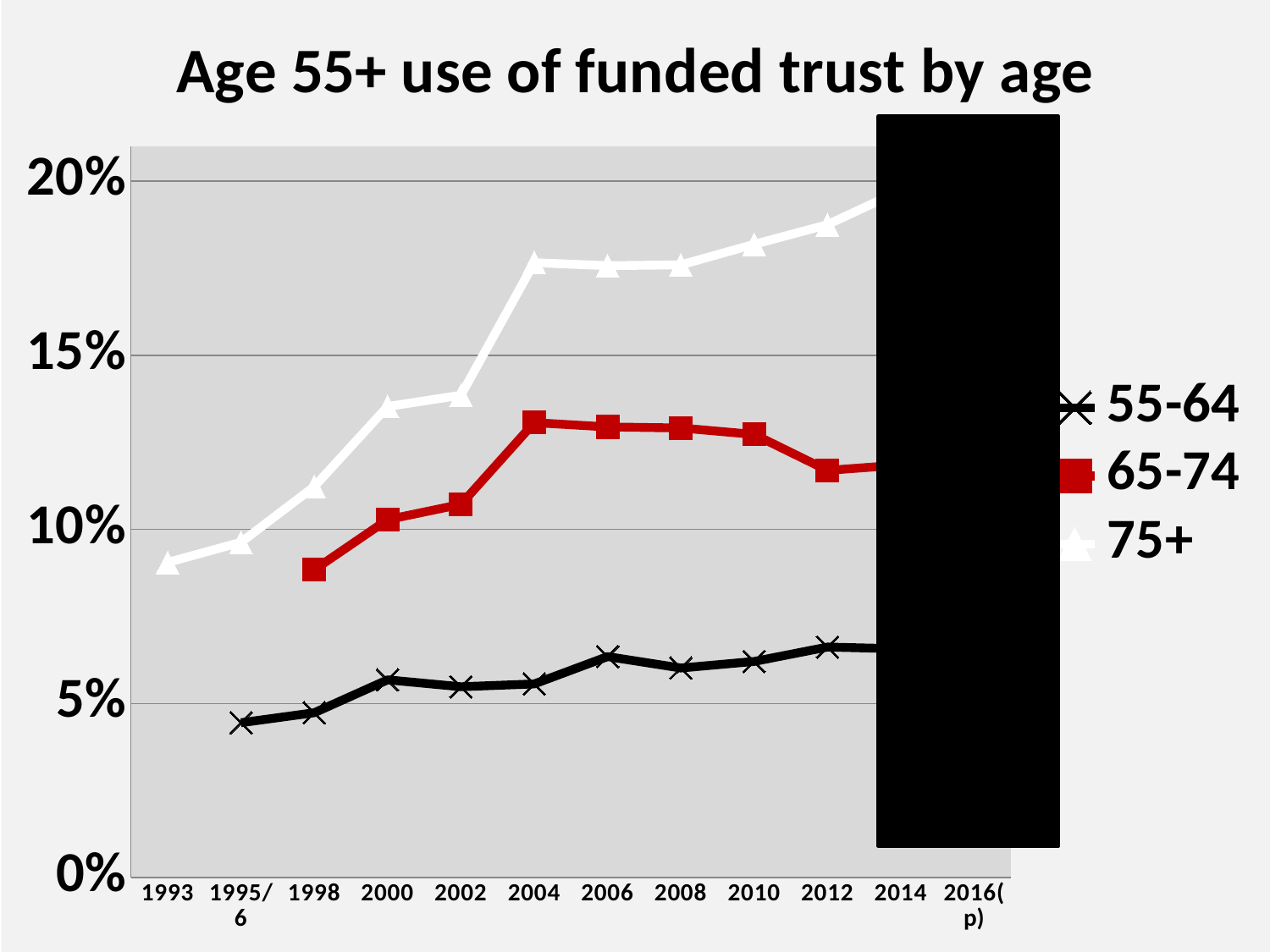
Is the value for the 55-64 series in 2006 greater or less than 5%? greater In 2010, which series has the larger value, 75+ or 65-74? 75+ Is the value for the 75+ series in 2004 greater or less than 15%? greater Is the value for the 75+ series in 1993 greater or less than 10%? less What is the title of the chart? Age 55+ use of funded trust by age Which series has the lowest values across the years shown? 55-64 What kind of chart is shown on the slide? line chart Does the 75+ series rise or fall from 1993 to 2012? rise How many year labels are shown on the x axis? 12 Which series is drawn in red? 65-74 How many series does the legend list? 3